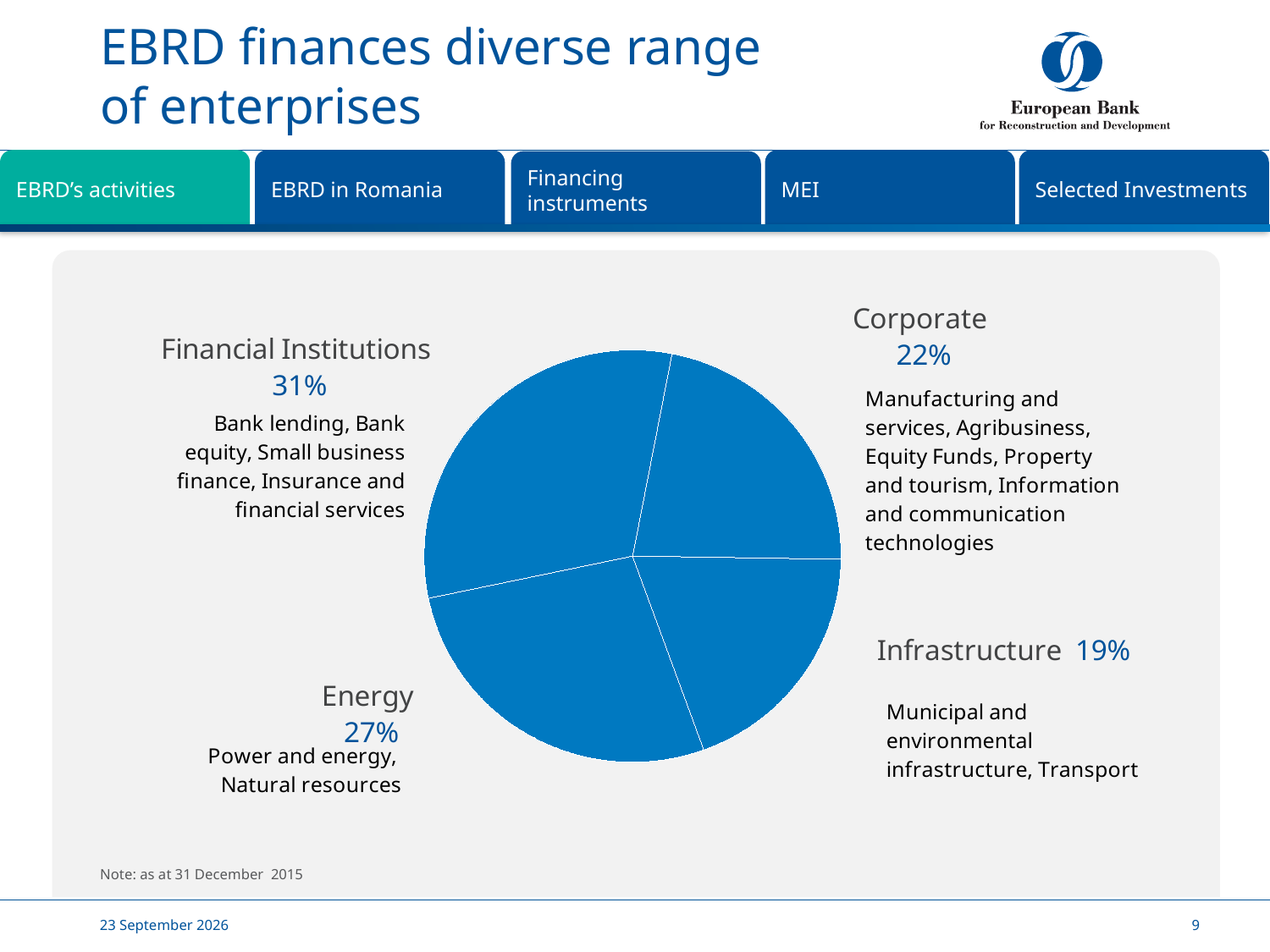
What share of the pie does Financial Institutions account for? 31% What kind of chart is shown on the slide? pie chart Which sector has the largest share of the pie? Financial Institutions Which sector has the smallest share of the pie? Infrastructure What is the value shown for Energy? 27% What is the difference in percentage points between Financial Institutions and Infrastructure? 12 How many slices does the pie chart have? 4 What is the difference in percentage points between Energy and Corporate? 5 According to the note, as at what date are the chart figures given? 31 December 2015 What is the value shown for Corporate? 22% Which is larger, the share for Energy or the share for Corporate? Energy What is the value shown for Infrastructure? 19%